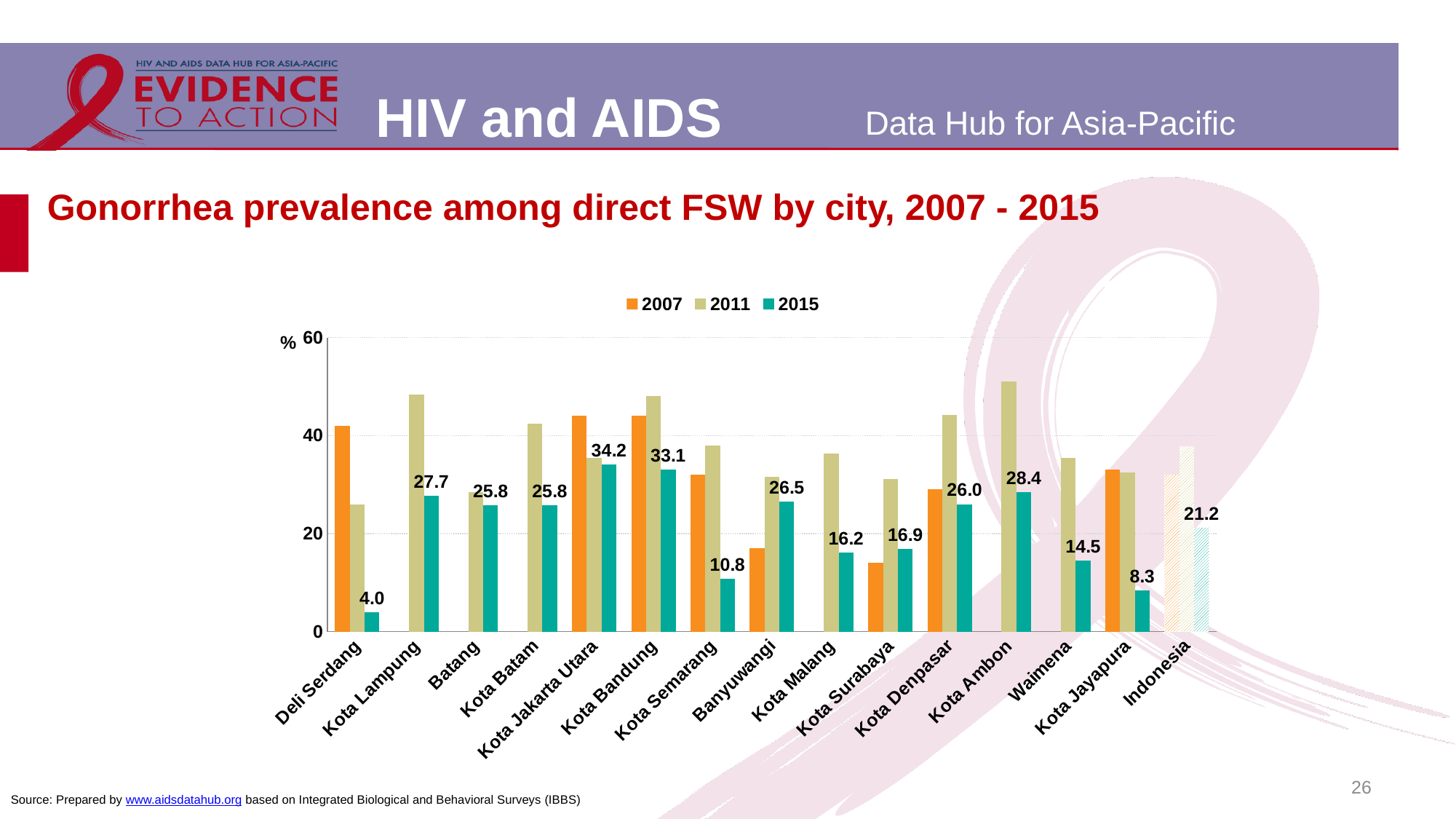
How many cities/categories are shown on the x axis? 15 Is the 2007 value for Kota Surabaya greater or less than 20? less Which city has the highest 2015 value? Kota Jakarta Utara What is the 2015 gonorrhea prevalence value for Kota Jakarta Utara? 34.2 How many series does the legend list? 3 Which has the larger 2015 value, Kota Ambon or Kota Lampung? Kota Ambon What kind of chart is shown on the slide? Bar chart What is the difference between the 2015 values for Kota Jakarta Utara and Kota Bandung? 1.1 What is the 2015 value for Indonesia? 21.2 Which city has the lowest 2015 value? Deli Serdang What is the 2015 value for Deli Serdang? 4.0 Is the 2011 value for Kota Ambon greater or less than 40? greater